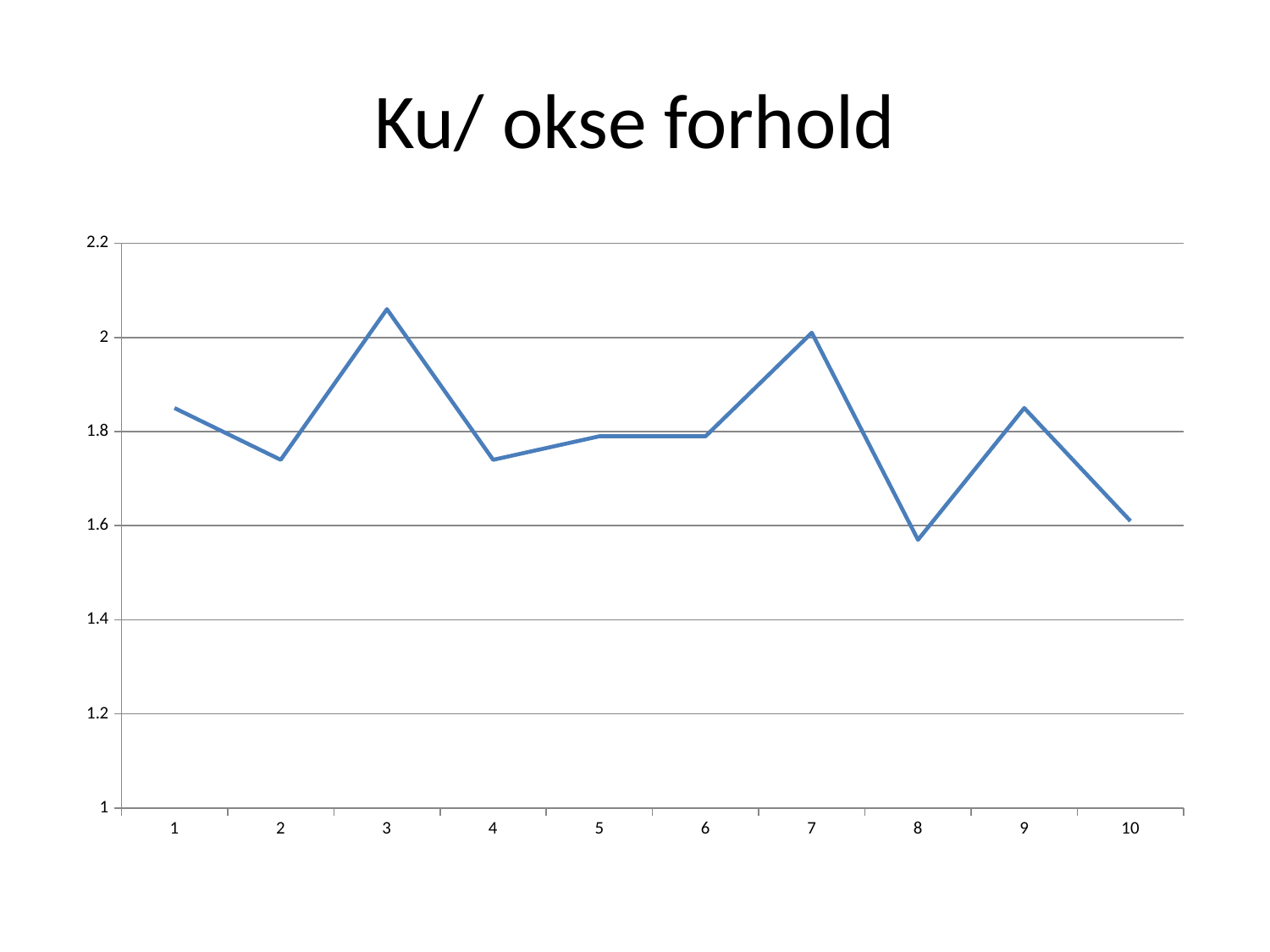
Is the value at point 8 greater or less than 1.6? less Which has the larger value, point 7 or point 8? point 7 Does the value rise or fall from point 7 to point 8? fall At which x-axis point is the value highest? 3 What is the title of the chart? Ku/ okse forhold How many points are plotted along the x axis? 10 Is the value at point 9 greater or less than 1.8? greater What kind of chart is shown on the slide? line chart Which has the larger value, point 1 or point 2? point 1 At which x-axis point is the value lowest? 8 Is the value at point 3 greater or less than 2? greater